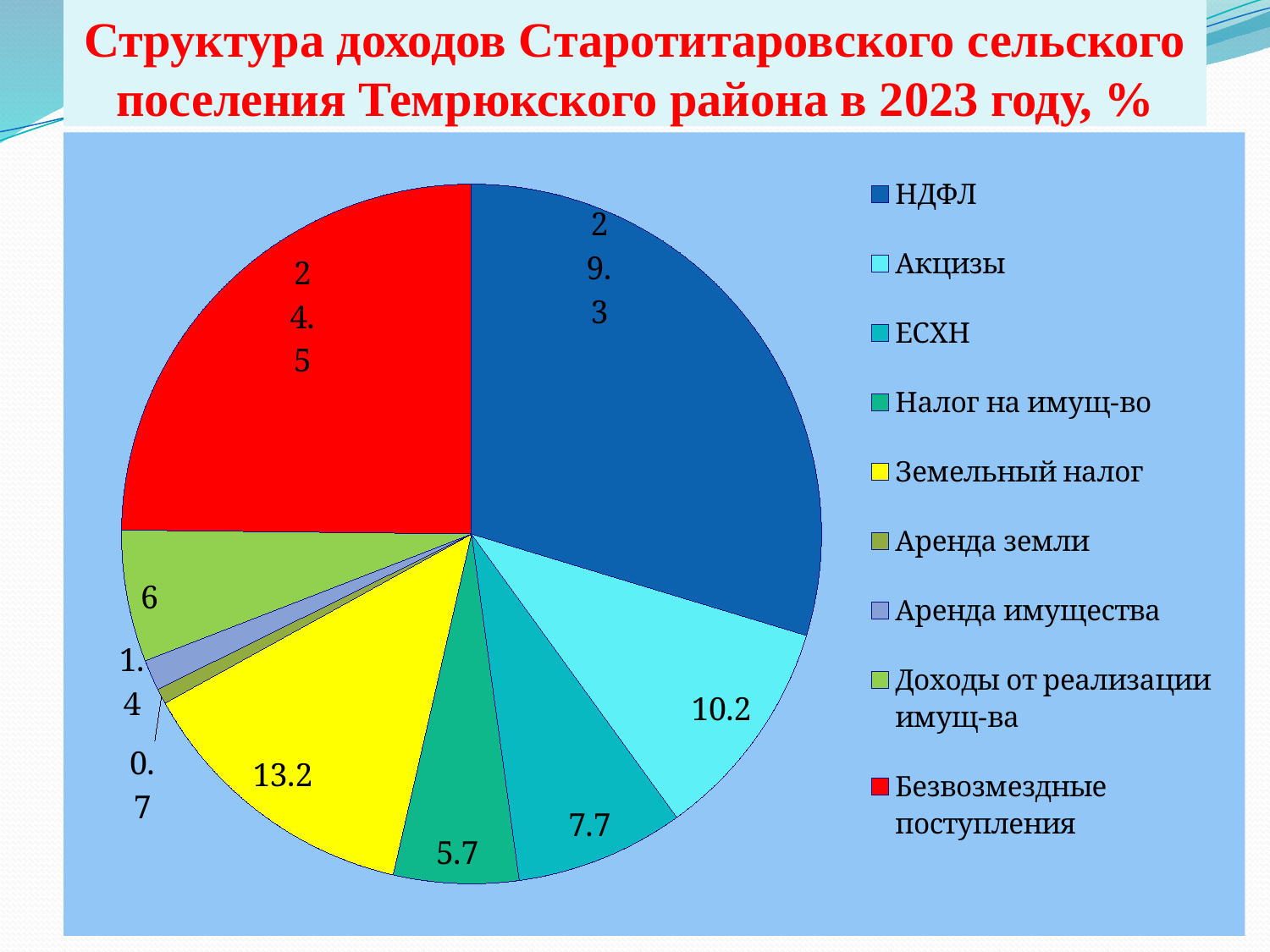
Which category has the smallest slice of the pie? Аренда земли What is the value for Акцизы? 10.2 What is the value for Земельный налог? 13.2 How many categories does the legend list? 9 What is the value for Безвозмездные поступления? 24.5 Which is larger, the value for Земельный налог or the value for Акцизы? Земельный налог Which category has the largest slice of the pie? НДФЛ What is the value for ЕСХН? 7.7 What colour is the slice for Безвозмездные поступления? red What is the value for НДФЛ? 29.3 What kind of chart is shown on the slide? pie chart What is the difference between the values for НДФЛ and Безвозмездные поступления? 4.8